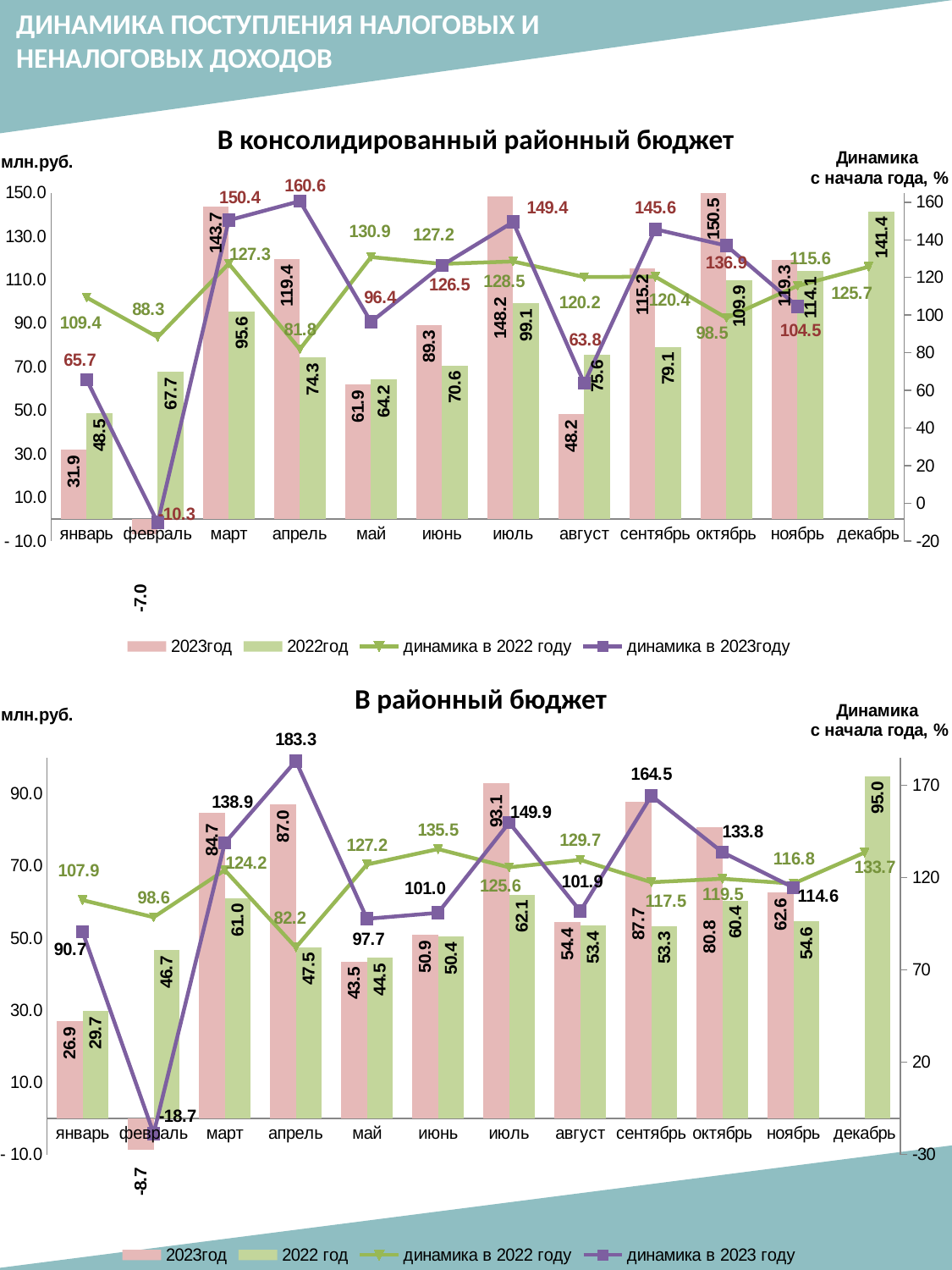
In the chart 'В консолидированный районный бюджет', what is the value of 'динамика в 2023году' for апрель? 160.6 In the chart 'В консолидированный районный бюджет', which month has the lowest 2023год bar? февраль In the chart 'В районный бюджет', what is the difference between 'динамика в 2022 году' and 'динамика в 2023 году' for май? 29.5 In the chart 'В районный бюджет', which month has the highest 2023год bar? июль In the chart 'В консолидированный районный бюджет', what is the difference between the 2023год and 2022год bars for март? 48.1 In the chart 'В районный бюджет', what is the value of the 2022 год bar for декабрь? 95.0 In the chart 'В консолидированный районный бюджет', what is the value of the 2023год bar for октябрь? 150.5 In the chart 'В районный бюджет', what is the value of 'динамика в 2023 году' for апрель? 183.3 In the chart 'В районный бюджет', which is larger for сентябрь: the 2023год bar or the 2022 год bar? 2023год In the chart 'В районный бюджет', how many months are shown on the x axis? 12 In the chart 'В консолидированный районный бюджет', what is the value of the 2022год bar for декабрь? 141.4 In the chart 'В консолидированный районный бюджет', how many series does the legend list? 4